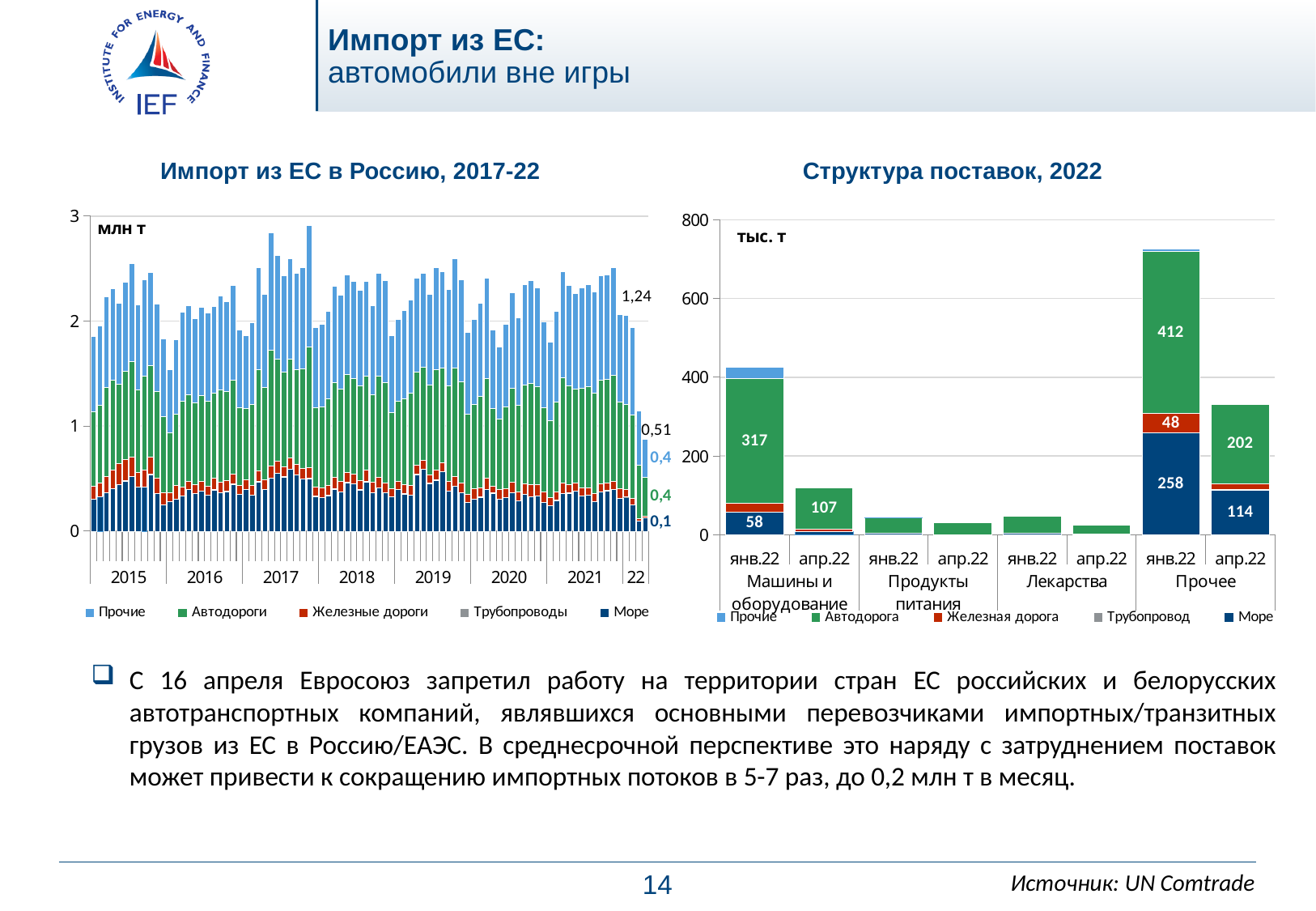
In the chart 'Структура поставок, 2022', is the total for Прочее in янв.22 greater or less than 600? greater In the chart 'Структура поставок, 2022', what is the value of Железная дорога for Прочее in янв.22? 48 In the chart 'Структура поставок, 2022', what is the value of Автодорога for Машины и оборудование in янв.22? 317 In the chart 'Структура поставок, 2022', what is the difference between the Автодорога values for Прочее in янв.22 and апр.22? 210 In the chart 'Структура поставок, 2022', what is the value of Море for Прочее in апр.22? 114 What kind of chart is 'Импорт из ЕС в Россию, 2017-22'? Stacked bar chart In the chart 'Структура поставок, 2022', which category has the tallest bar for янв.22? Прочее In the chart 'Структура поставок, 2022', what is the value of Море for Прочее in янв.22? 258 In the chart 'Структура поставок, 2022', is the total for Продукты питания in янв.22 greater or less than 200? less In the chart 'Структура поставок, 2022', which is larger: Море for Машины и оборудование in янв.22 or Море for Прочее in апр.22? Море for Прочее in апр.22 In the chart 'Структура поставок, 2022', what is the difference between the Автодорога values for Машины и оборудование in янв.22 and апр.22? 210 How many series does the legend of the chart 'Структура поставок, 2022' list? 5